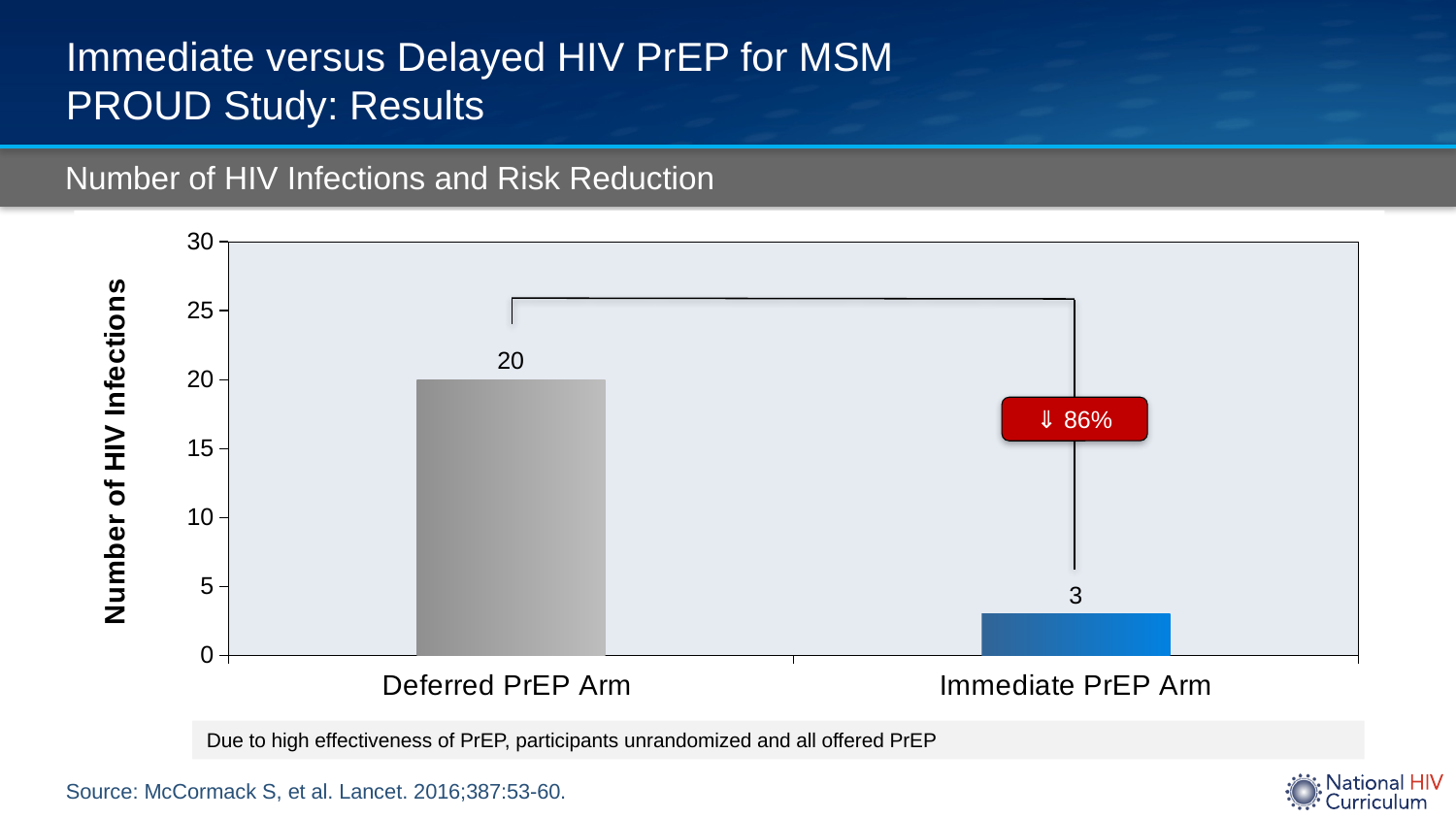
What percentage risk reduction is shown in the red label on the chart? 86% What is the number of HIV infections in the Deferred PrEP Arm? 20 What is the number of HIV infections in the Immediate PrEP Arm? 3 How many categories (arms) are shown on the x axis of the chart? 2 Which arm had the lowest number of HIV infections? Immediate PrEP Arm What is the difference in the number of HIV infections between the Deferred PrEP Arm and the Immediate PrEP Arm? 17 Which arm had the highest number of HIV infections? Deferred PrEP Arm What is the label of the y axis of the chart? Number of HIV Infections What is the maximum value shown on the y axis of the chart? 30 Which arm had more HIV infections, the Deferred PrEP Arm or the Immediate PrEP Arm? Deferred PrEP Arm Is the number of HIV infections in the Immediate PrEP Arm greater or less than 5? less What kind of chart is shown on the slide? Bar chart